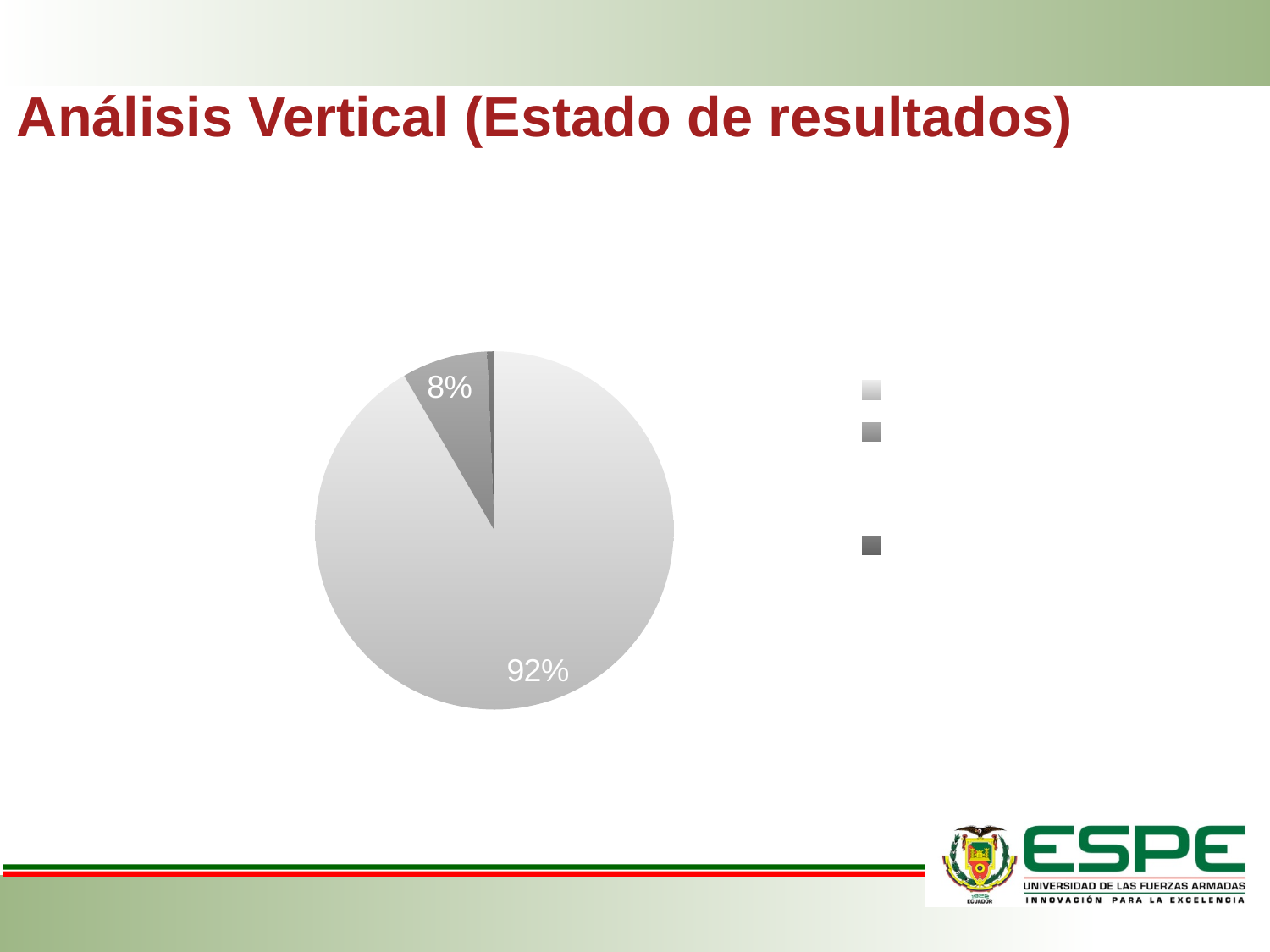
How many data labels are printed on the pie chart? 2 Is the share of the medium grey slice greater or less than 10%? less What is the value printed on the smaller labelled slice of the pie chart? 8% What kind of chart is shown on the slide? pie chart How many entries does the legend of the pie chart list? 3 What is the value printed on the largest slice of the pie chart? 92% Is the share of the largest slice greater or less than 50%? greater What colour is the largest slice of the pie chart? light grey What is the difference in percentage points between the 92% slice and the 8% slice? 84 What is the title of the slide containing the pie chart? Análisis Vertical (Estado de resultados) Which slice is larger, the light grey slice or the medium grey slice? the light grey slice